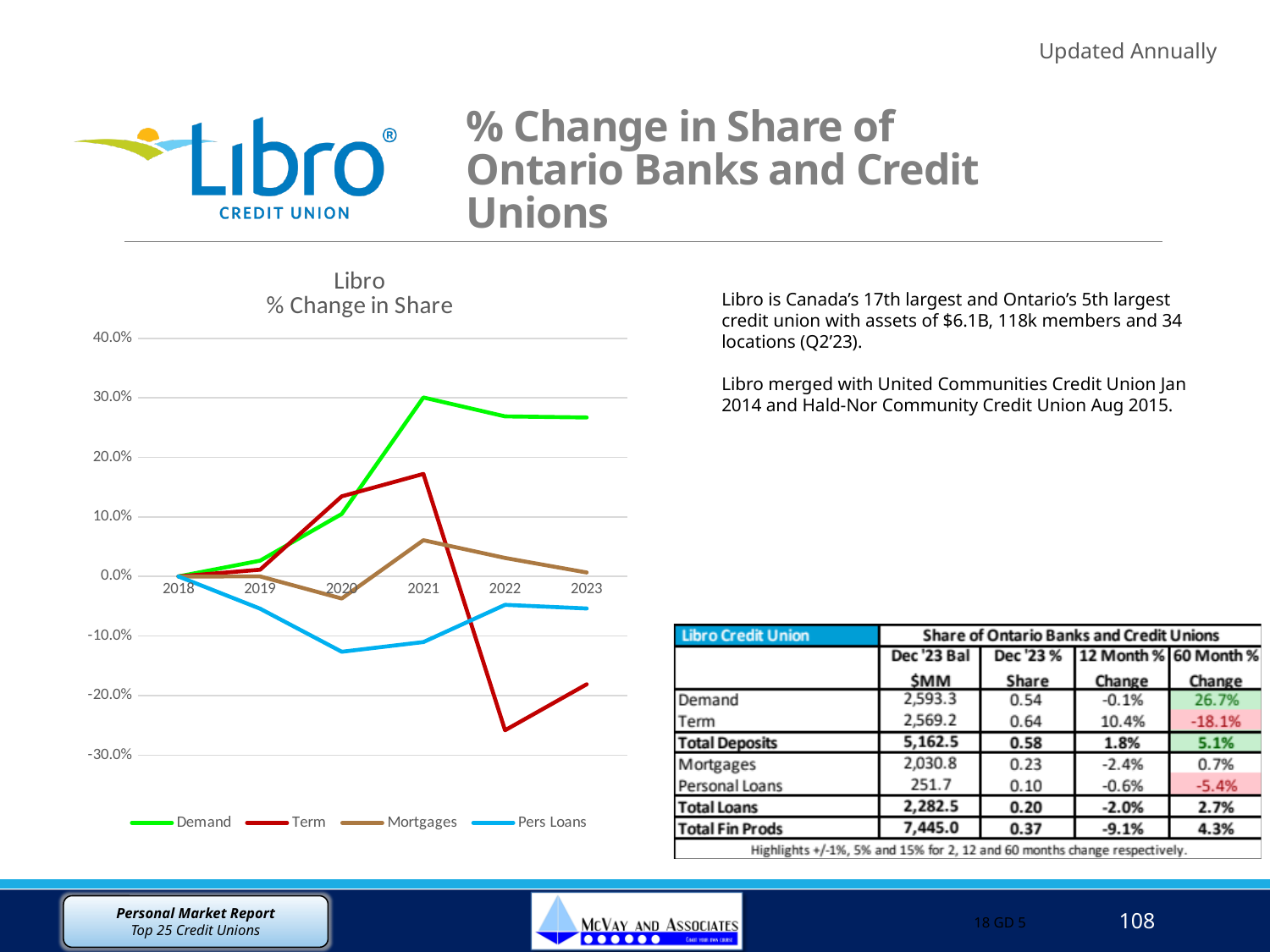
In 2023, which is larger: the value for Demand or the value for Term? Demand How many years are shown along the x axis of the chart? 6 How many series does the chart legend list? 4 What colour is the Demand line in the chart? green What kind of chart is shown on the slide? line chart Which series has the highest value in 2023? Demand Is the value for Term in 2022 greater or less than -20.0%? less Does the Demand line rise or fall from 2018 to 2021? rise Which series has the lowest value in 2022? Term What is the title of the chart? Libro % Change in Share Is the value for Demand in 2021 greater or less than 20.0%? greater Is the value for Pers Loans in 2020 greater or less than -10.0%? less